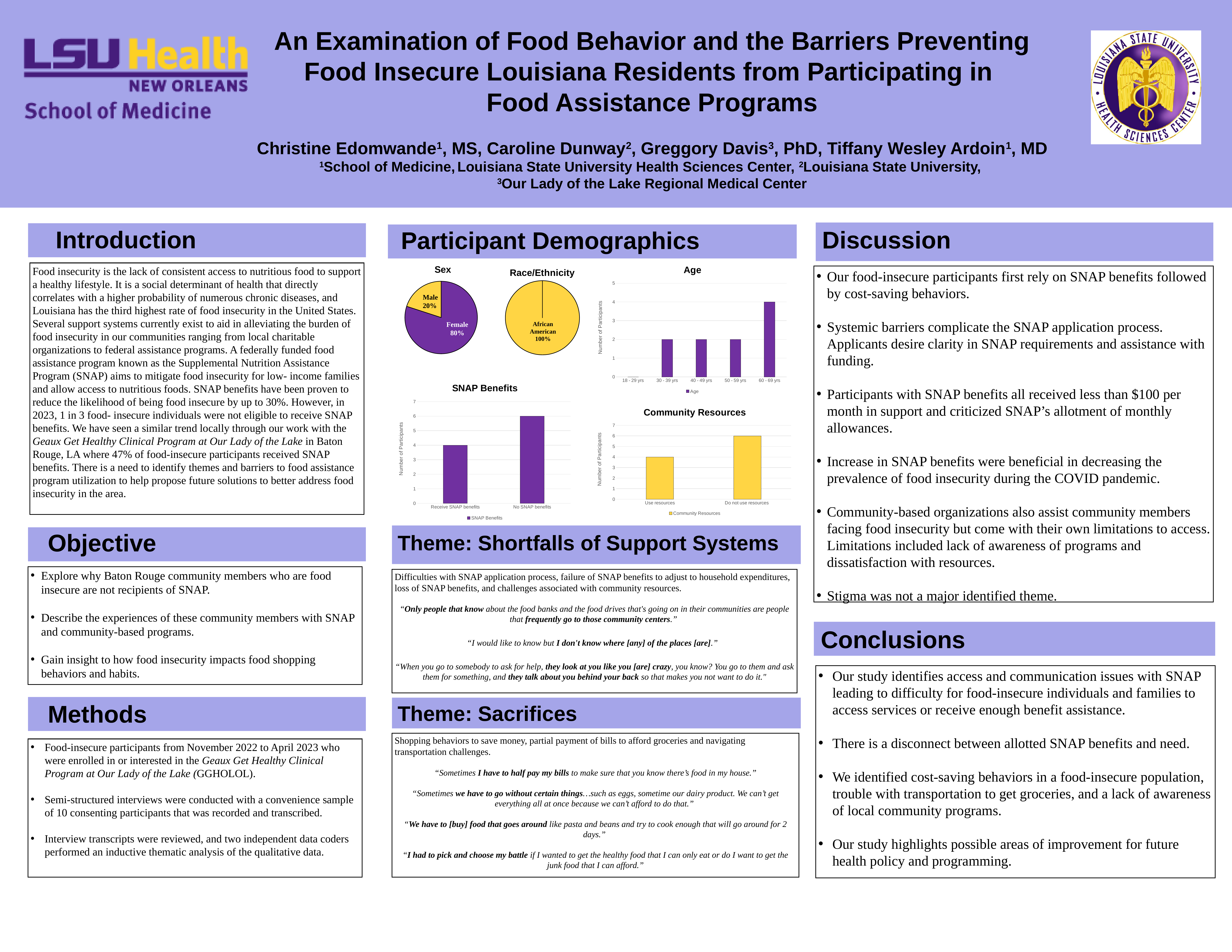
In the Age chart, which age group has the lowest number of participants? 18 - 29 yrs What kind of chart is the Community Resources chart? Bar chart In the Community Resources chart, which is larger: the number who use resources or the number who do not use resources? Do not use resources In the Age chart, which age group has the highest number of participants? 60 - 69 yrs In the Age chart, how many age groups are shown on the x axis? 5 In the SNAP Benefits chart, how many participants receive SNAP benefits? 4 In the Age chart, how many participants are in the 60 - 69 yrs group? 4 In the Community Resources chart, how many participants do not use resources? 6 In the Sex pie chart, what share of participants are Female? 80% In the Race/Ethnicity pie chart, what share of participants are African American? 100% In the SNAP Benefits chart, what is the difference between the number of participants with no SNAP benefits and those who receive SNAP benefits? 2 In the Sex pie chart, what share of participants are Male? 20%